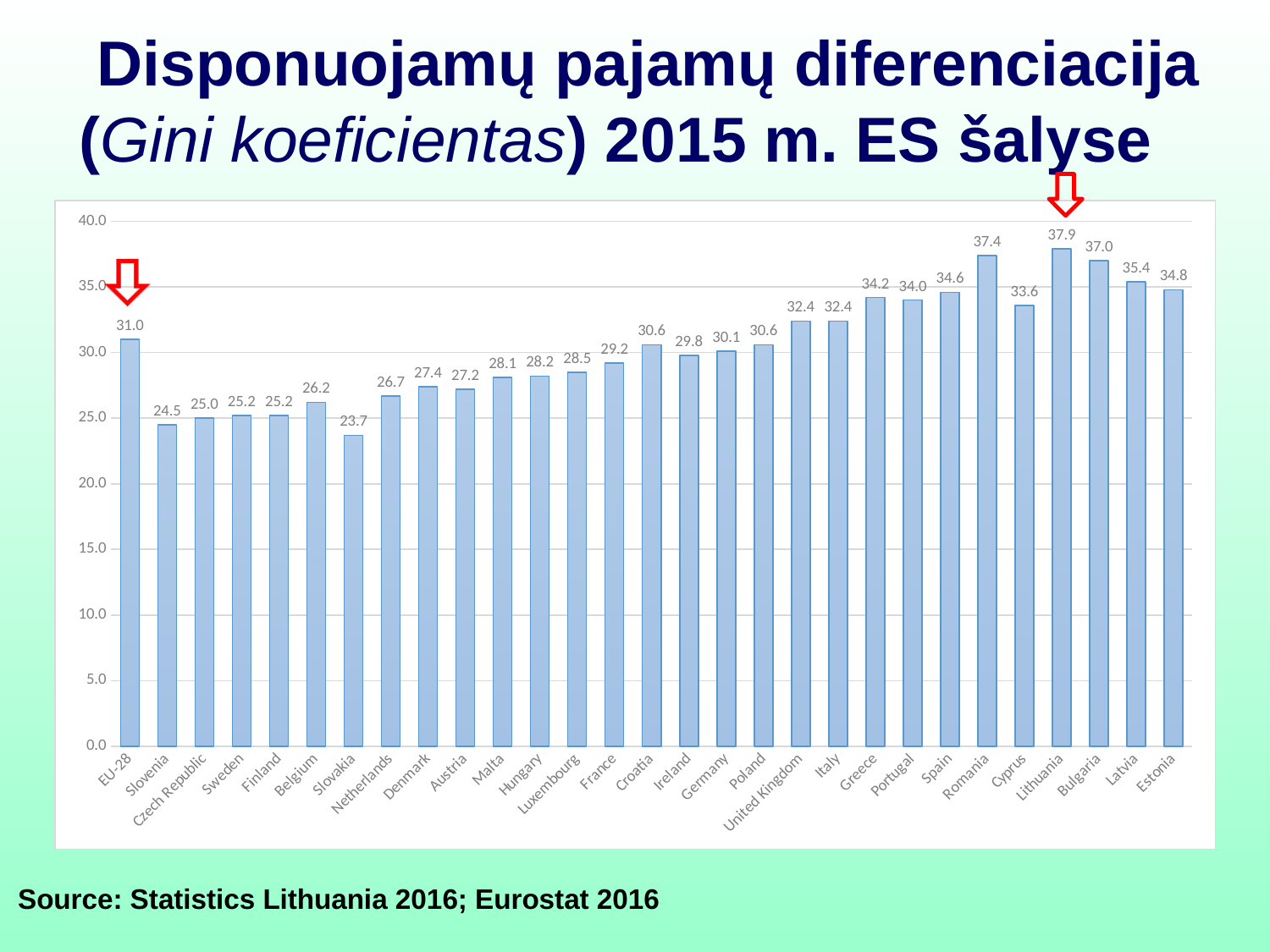
What is the value shown for Romania? 37.4 Which country has the lowest value in the chart? Slovakia What type of chart is shown on the slide? Bar chart What is the value shown for Slovakia? 23.7 What is the value shown for EU-28? 31.0 What is the difference between the values for Lithuania and EU-28? 6.9 Which has a higher value, Germany or Ireland? Germany Which country has the highest value in the chart? Lithuania What is the difference between the values for Romania and Bulgaria? 0.4 What is the Gini coefficient value shown for Lithuania? 37.9 Which has a higher value, Latvia or Estonia? Latvia How many bars are plotted in the chart? 29